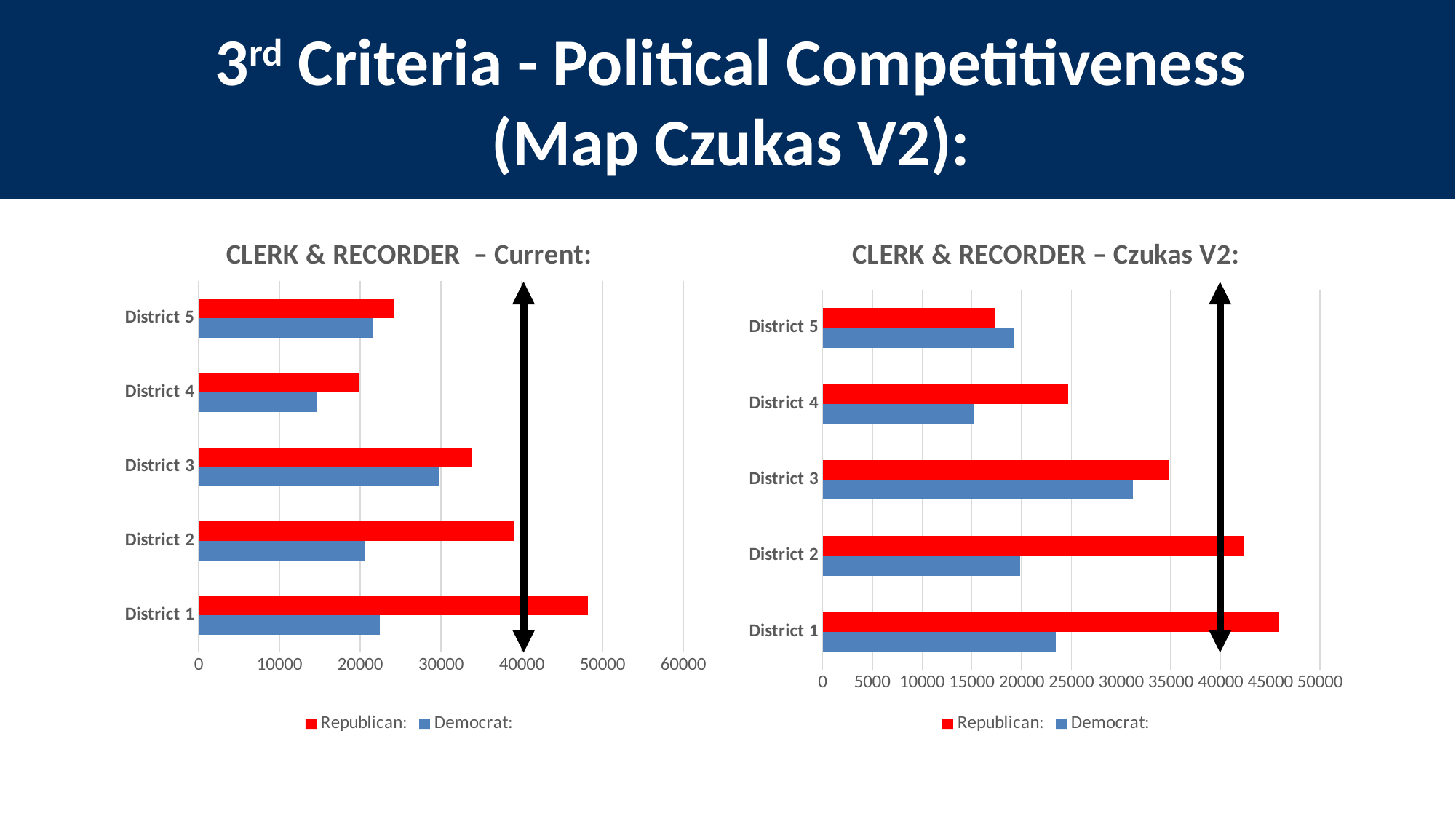
In the CLERK & RECORDER – Czukas V2 chart, is the Republican value for District 2 greater or less than 40000? greater In the CLERK & RECORDER – Current chart, which district has the highest Republican value? District 1 In the CLERK & RECORDER – Czukas V2 chart, is the Republican value for District 4 greater or less than 20000? greater In the CLERK & RECORDER – Czukas V2 chart, which district has the highest Republican value? District 1 In the CLERK & RECORDER – Current chart, how many districts are shown? 5 What kind of chart is the CLERK & RECORDER – Czukas V2 chart? bar chart In the CLERK & RECORDER – Current chart, which district has the lowest Democrat value? District 4 In the CLERK & RECORDER – Czukas V2 chart, for District 5, which is larger: the Republican value or the Democrat value? Democrat In the CLERK & RECORDER – Current chart, how many series does the legend list? 2 In the CLERK & RECORDER – Current chart, is the Republican value for District 1 greater or less than 40000? greater In the CLERK & RECORDER – Czukas V2 chart, which district has the lowest Democrat value? District 4